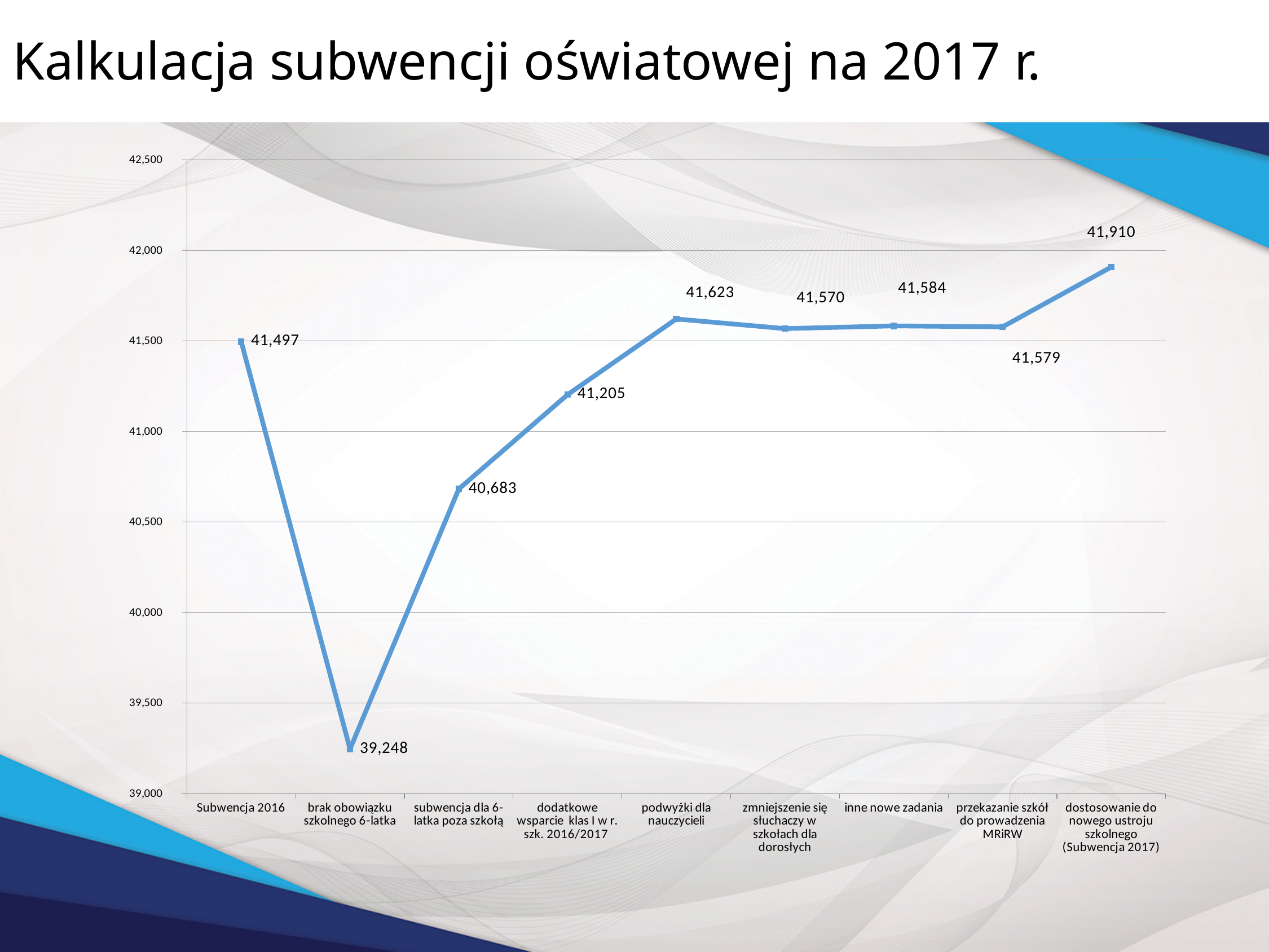
How many data points are plotted on the line? 9 What type of chart is shown on the slide? line chart Which is larger: the value for "podwyżki dla nauczycieli" or the value for "dodatkowe wsparcie klas I w r. szk. 2016/2017"? podwyżki dla nauczycieli Which category has the lowest value? brak obowiązku szkolnego 6-latka What is the value for "brak obowiązku szkolnego 6-latka"? 39,248 What is the value for "dostosowanie do nowego ustroju szkolnego (Subwencja 2017)"? 41,910 What is the difference between the value for "dostosowanie do nowego ustroju szkolnego (Subwencja 2017)" and the value for "Subwencja 2016"? 413 What is the title of the slide? Kalkulacja subwencji oświatowej na 2017 r. What is the difference between the value for "subwencja dla 6-latka poza szkołą" and the value for "brak obowiązku szkolnego 6-latka"? 1,435 What is the value for "podwyżki dla nauczycieli"? 41,623 What is the value for "Subwencja 2016"? 41,497 Which category has the highest value? dostosowanie do nowego ustroju szkolnego (Subwencja 2017)